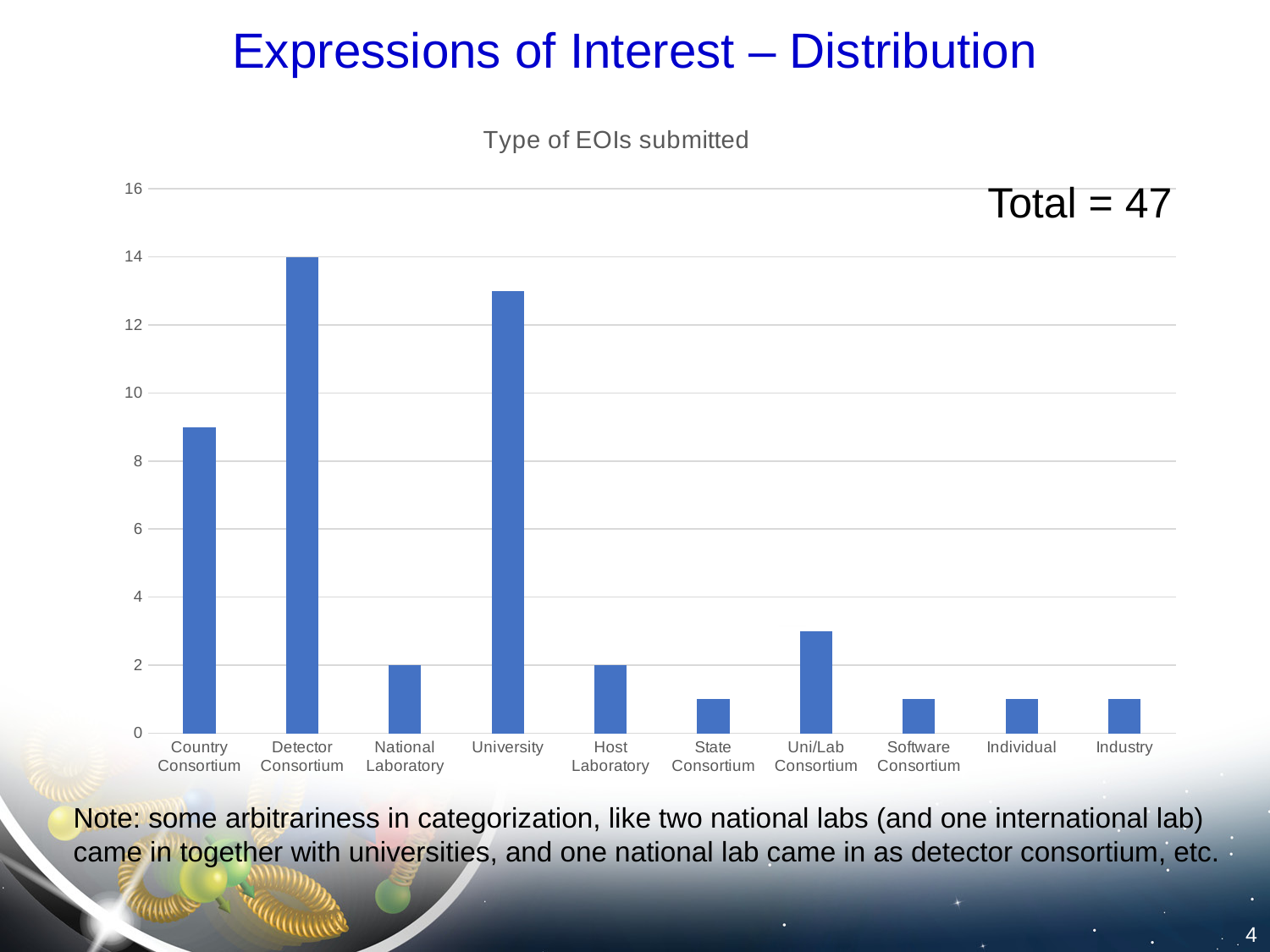
What total number of EOIs is stated on the slide next to the chart? Total = 47 Which is larger, the value for Country Consortium or the value for University? University Which category has the highest number of EOIs submitted? Detector Consortium How many categories are shown on the x axis of the chart? 10 Is the value for University greater or less than 14? less What is the value for National Laboratory? 2 What is the value for Detector Consortium? 14 What is the title of the chart? Type of EOIs submitted What type of chart is shown on the slide? bar chart What is the value for Host Laboratory? 2 Is the value for Country Consortium greater or less than 8? greater Is the value for Uni/Lab Consortium greater or less than 2? greater